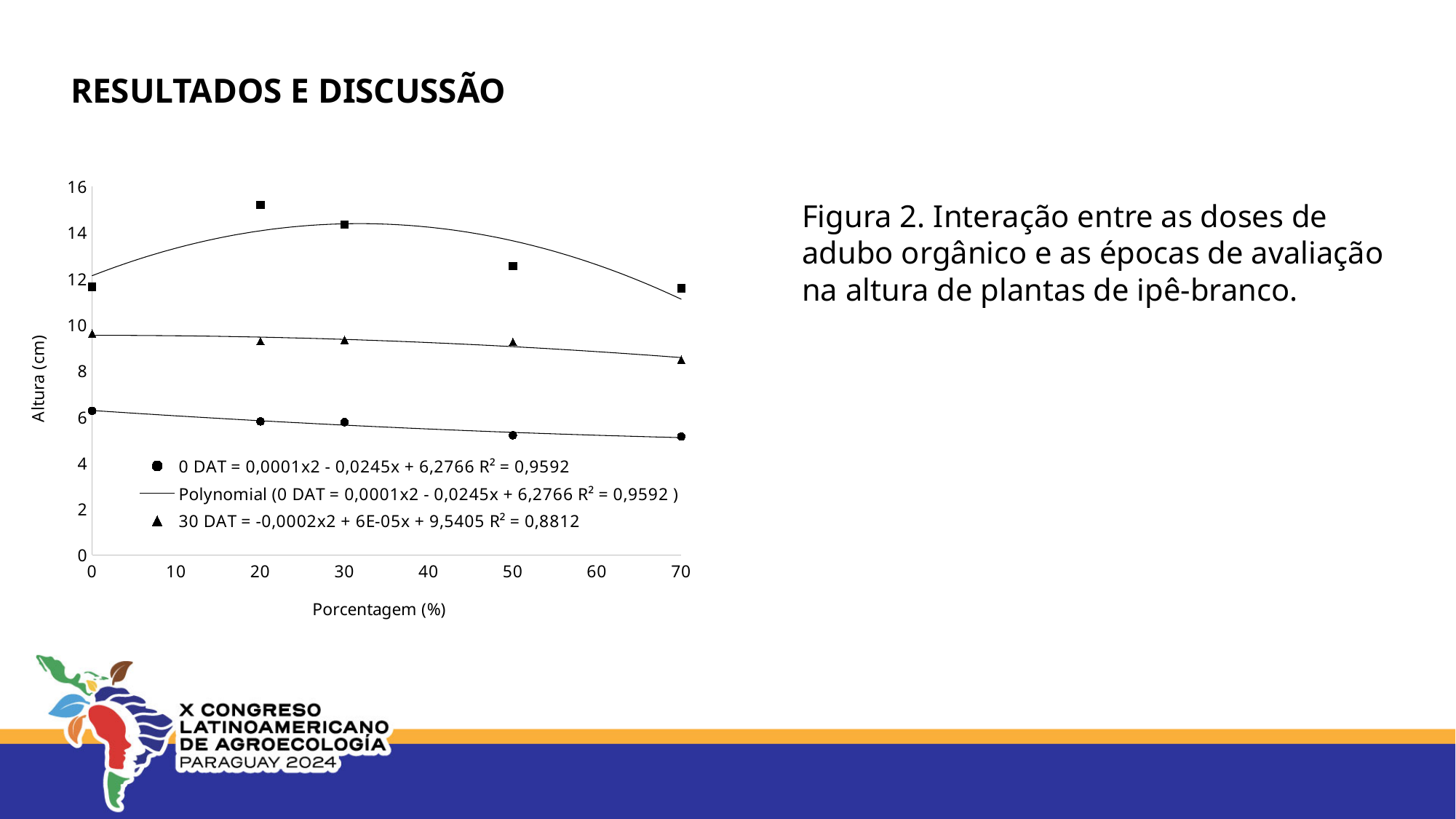
What kind of chart is shown on the slide? Scatter chart At which percentage does the square-marker series reach its highest value? 20 How many entries does the chart legend list? 3 Is the value for the 0 DAT series at 70% greater or less than 6? less How many data points are plotted for the 0 DAT series? 5 What is the title of the y axis? Altura (cm) Is the value of the square-marker series at 20% greater or less than 14? greater Is the value for the 30 DAT series at 0% greater or less than 10? less At which percentage does the 0 DAT series reach its highest value? 0 Do the values of the 0 DAT series rise or fall as the percentage increases from 0 to 70? fall What is the R² value shown in the legend for the 0 DAT series? 0,9592